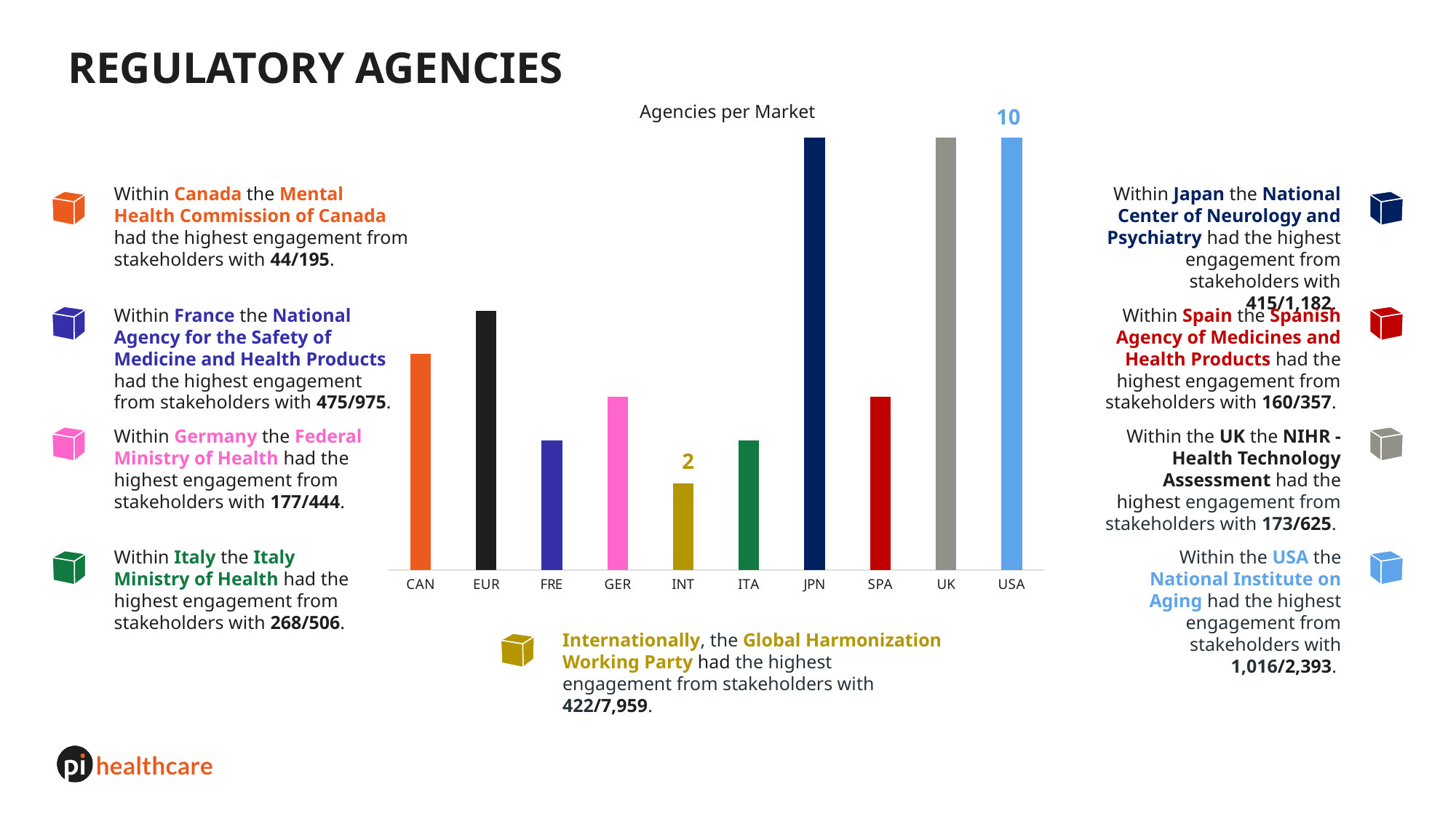
Which has the larger value, SPA or ITA? SPA Which has the larger value, CAN or FRE? CAN Which market has the lowest value in the chart? INT How many markets (categories) are shown on the x axis of the chart? 10 What is the difference between the values for USA and INT? 8 What type of chart is shown on the slide? bar chart What is the title of the chart? Agencies per Market Which has the larger value, JPN or SPA? JPN What is the value shown for INT in the chart? 2 What is the value shown for USA in the chart? 10 What colour is the bar for USA? light blue